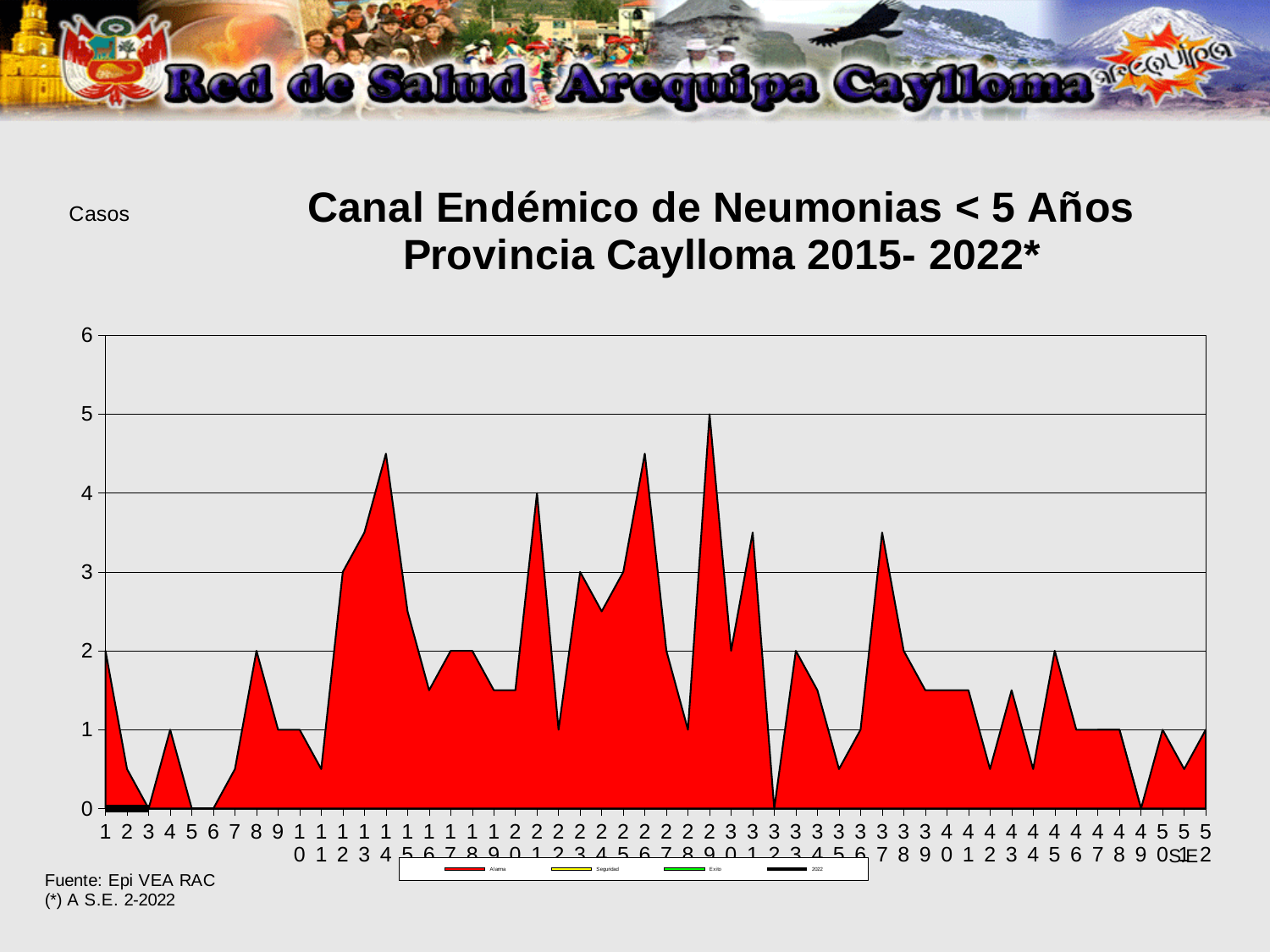
What type of chart is shown on the slide? Area chart What is the value of the red Alarma area at week 29? 5 What is the value of the red Alarma area at week 1? 2 Which week has the highest value in the red Alarma area? 29 How many series does the legend list? 4 Is the value of the red Alarma area at week 14 greater or less than 4? greater Which is larger, the red Alarma value at week 29 or at week 21? Week 29 What is the title of the chart? Canal Endémico de Neumonias < 5 Años Provincia Caylloma 2015- 2022* What is the value of the red Alarma area at week 21? 4 How many weeks (points) are shown along the x axis? 52